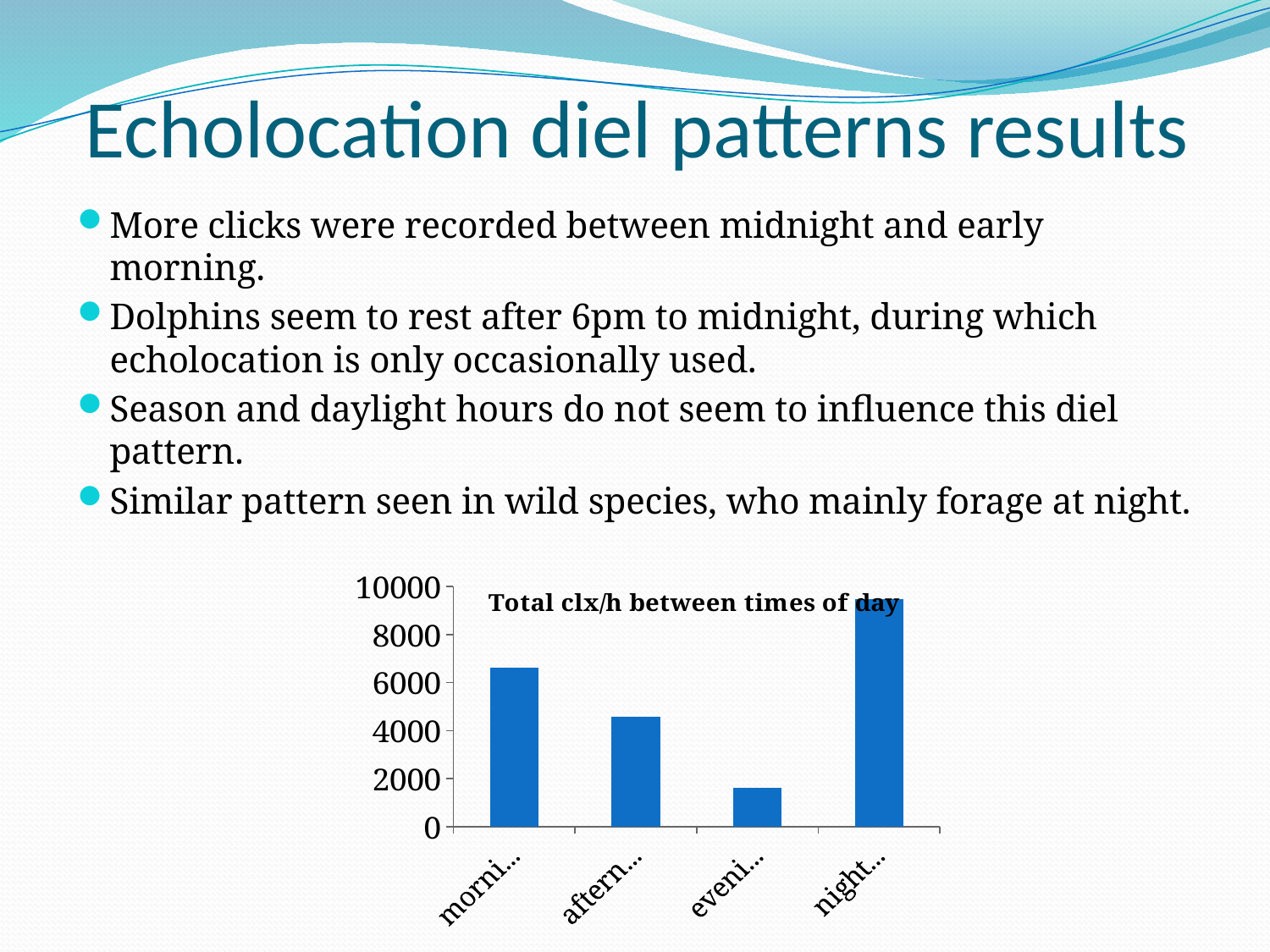
Which is larger, the value for morning or the value for afternoon? morning Which time of day has the highest total clx/h? night Is the value for morning greater or less than 6000? greater How many bars (time-of-day categories) does the chart show? 4 Is the value for night greater or less than 8000? greater What is the title of the chart? Total clx/h between times of day Which time of day has the lowest total clx/h? evening Which is larger, the value for evening or the value for night? night Do the values rise or fall from morning to evening? fall Is the value for afternoon greater or less than 6000? less What kind of chart is shown on the slide? bar chart